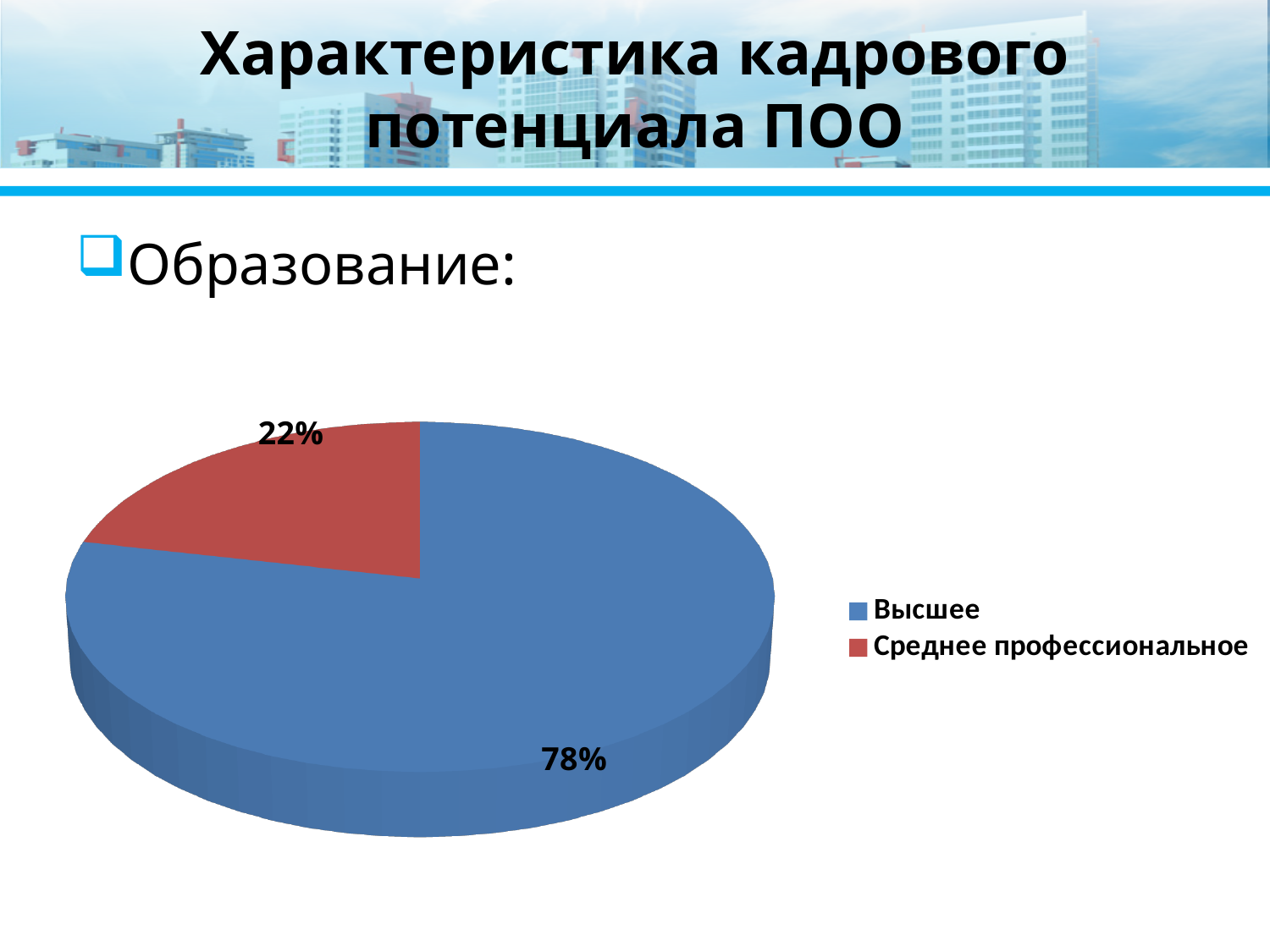
What kind of chart is shown on the slide? Pie chart What share of the pie does the "Среднее профессиональное" slice represent? 22% Which category has the smallest slice of the pie? Среднее профессиональное What colour is the "Среднее профессиональное" slice? Red What share of the pie does the "Высшее" slice represent? 78% Which is larger: the "Высшее" slice or the "Среднее профессиональное" slice? Высшее Which category has the largest slice of the pie? Высшее What is the difference in percentage points between the "Высшее" and "Среднее профессиональное" slices? 56% How many slices does the pie chart have? 2 What colour is the "Высшее" slice? Blue How many entries does the legend list? 2